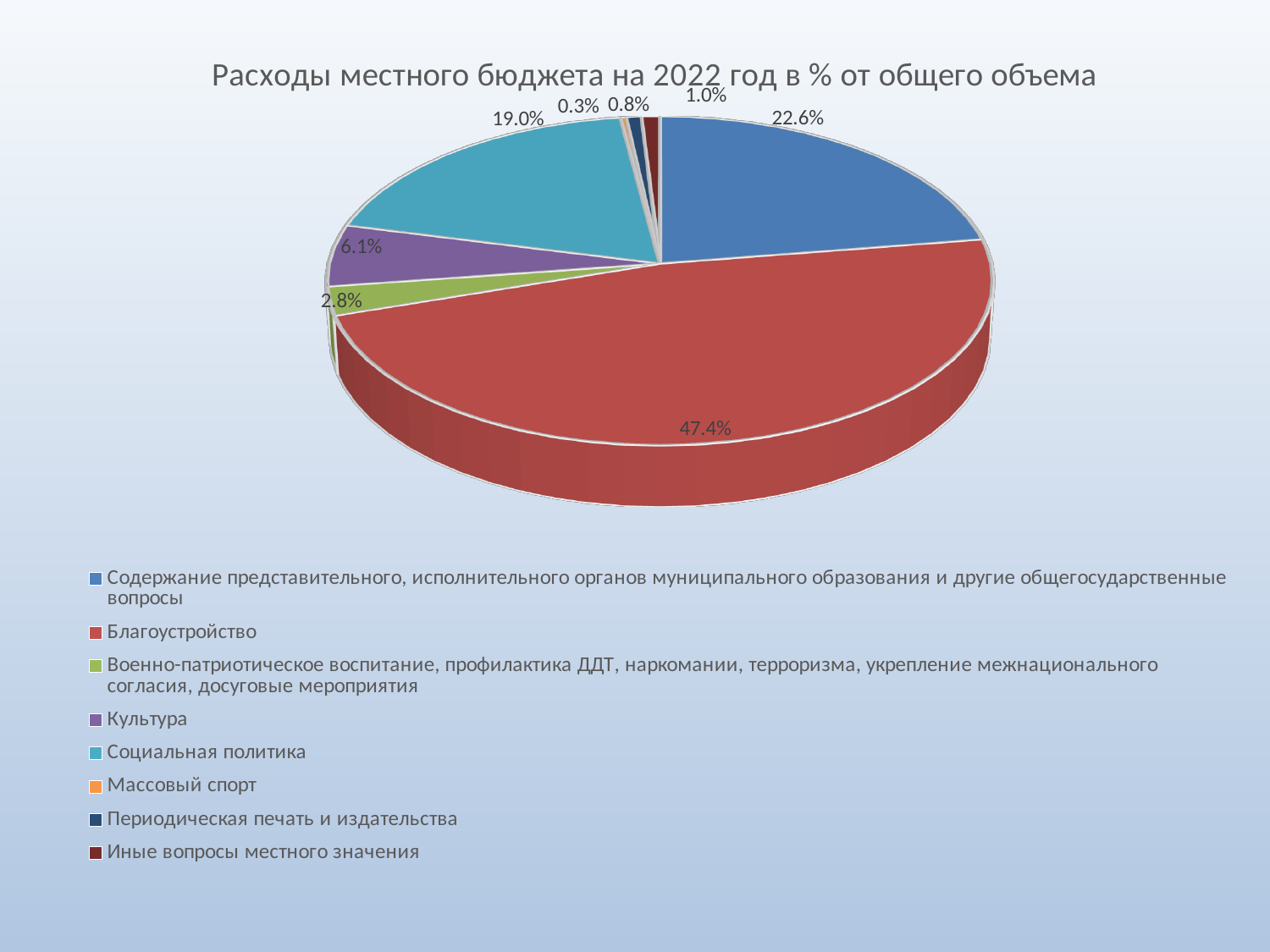
Which category has the smallest share of the budget? Массовый спорт Which is larger: the share for Культура or the share for Иные вопросы местного значения? Культура What is the value for Периодическая печать и издательства? 0.8% What is the title of the chart? Расходы местного бюджета на 2022 год в % от общего объема What is the value for Культура? 6.1% What share of the local budget expenditure goes to Благоустройство? 47.4% What percentage is shown for Массовый спорт? 0.3% What is the difference between the shares for Благоустройство and Социальная политика? 28.4% How many categories does the pie chart show? 8 Which category has the largest share of the budget? Благоустройство What type of chart is shown on the slide? Pie chart What percentage is shown for Социальная политика? 19.0%